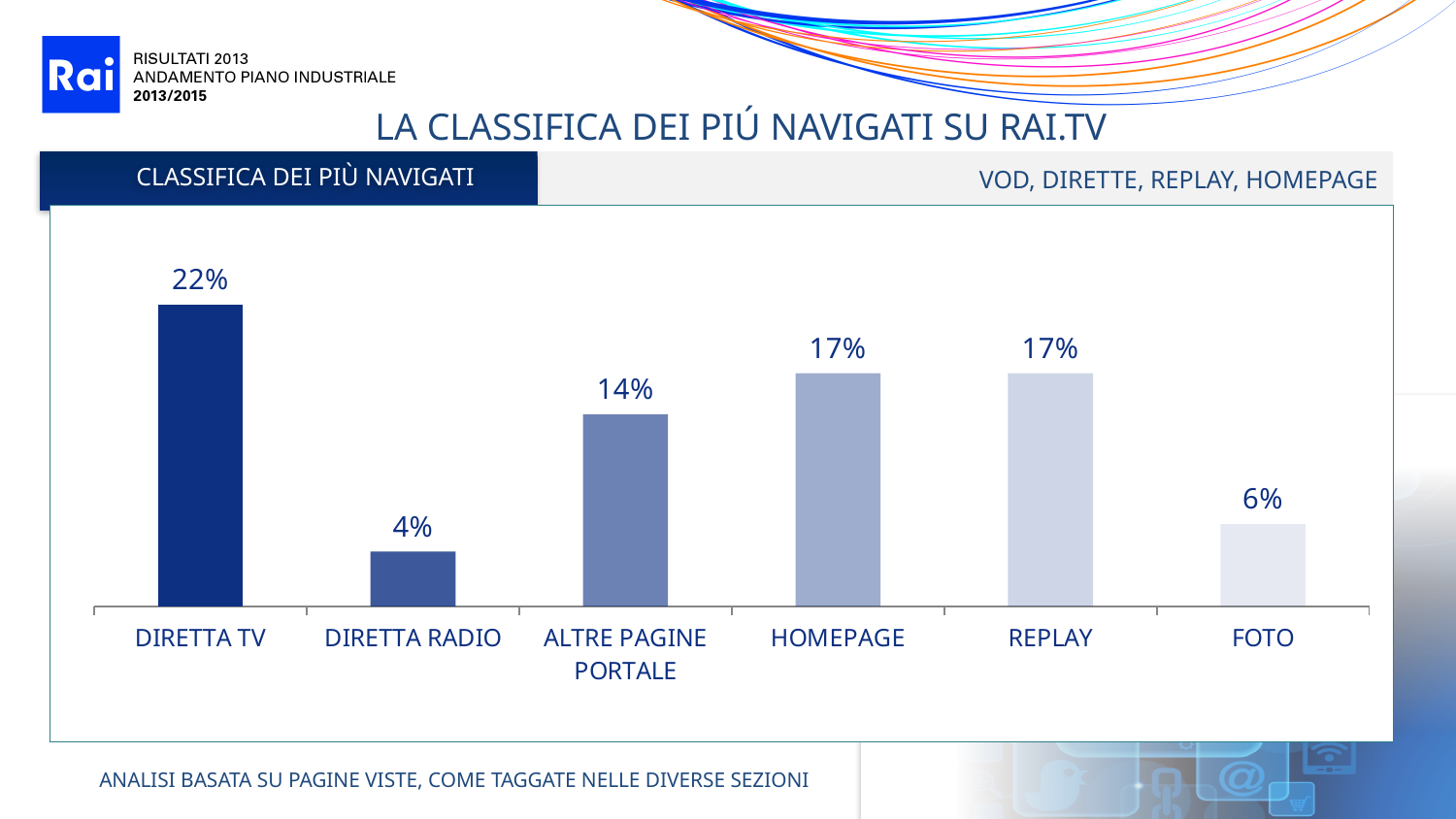
What is the difference between the values for ALTRE PAGINE PORTALE and FOTO? 8% What is the value for ALTRE PAGINE PORTALE? 14% Which category has the lowest value? DIRETTA RADIO What is the value for DIRETTA RADIO? 4% How many categories are shown in the chart? 6 Which category has the highest value? DIRETTA TV What is the difference between the values for DIRETTA TV and HOMEPAGE? 5% What is the value for DIRETTA TV? 22% What is the value for FOTO? 6% What is the title shown in the header box above the chart on the left? CLASSIFICA DEI PIÙ NAVIGATI What kind of chart is shown on the slide? Bar chart Which is larger, the value for HOMEPAGE or the value for ALTRE PAGINE PORTALE? HOMEPAGE